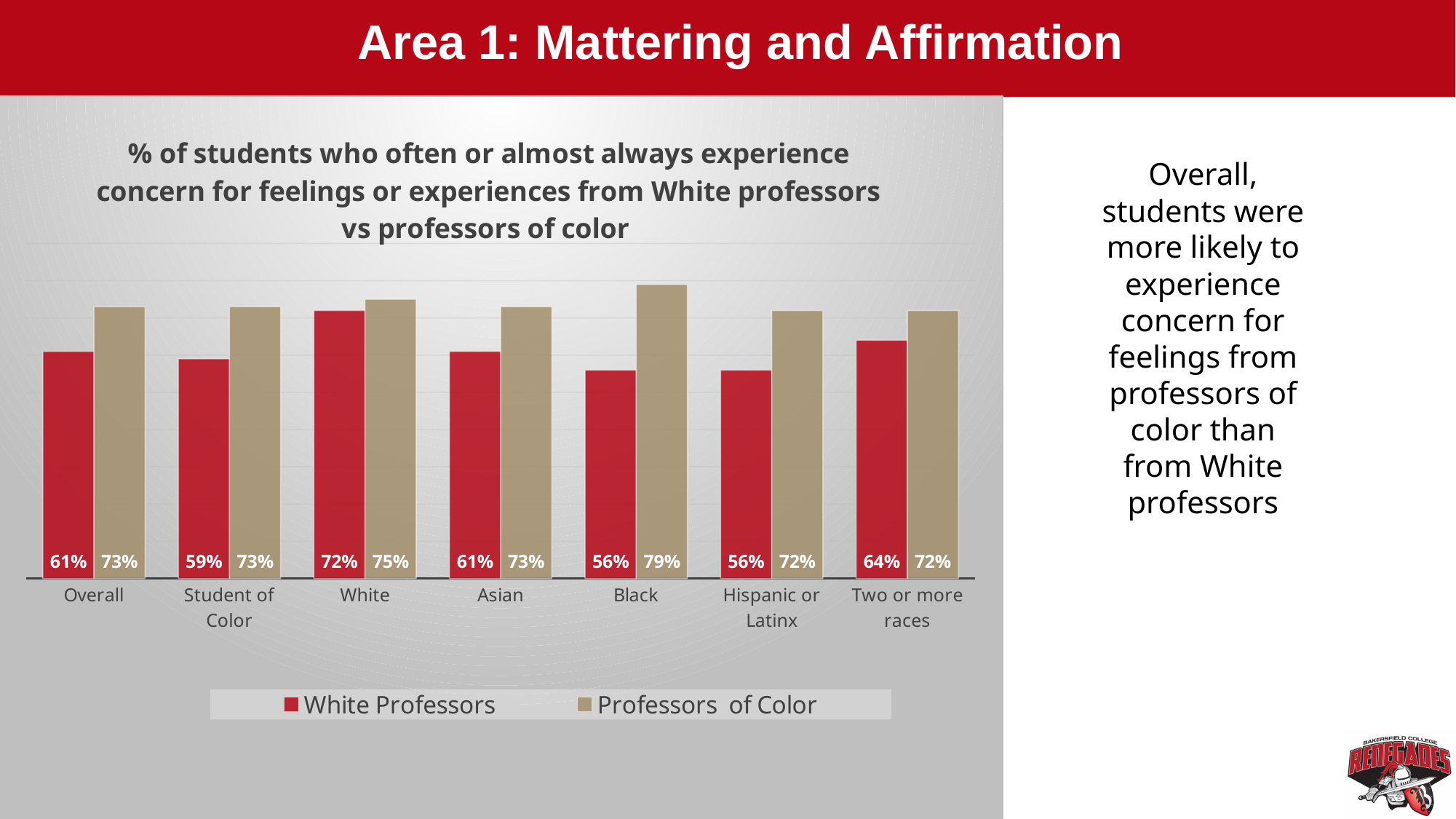
What is the value for White Professors in the Two or more races category? 64% What is the value for Professors of Color in the Black category? 79% What is the value for White Professors in the Overall category? 61% What kind of chart is shown on the slide? Bar chart How many series does the legend list? 2 Which is larger in the Asian category: White Professors or Professors of Color? Professors of Color Which category has the highest value for White Professors? White Which colour represents the White Professors series? Red How many categories are shown on the x axis? 7 What is the difference between Professors of Color and White Professors in the White category? 3% Which category has the highest value for Professors of Color? Black What is the difference between Professors of Color and White Professors in the Black category? 23%